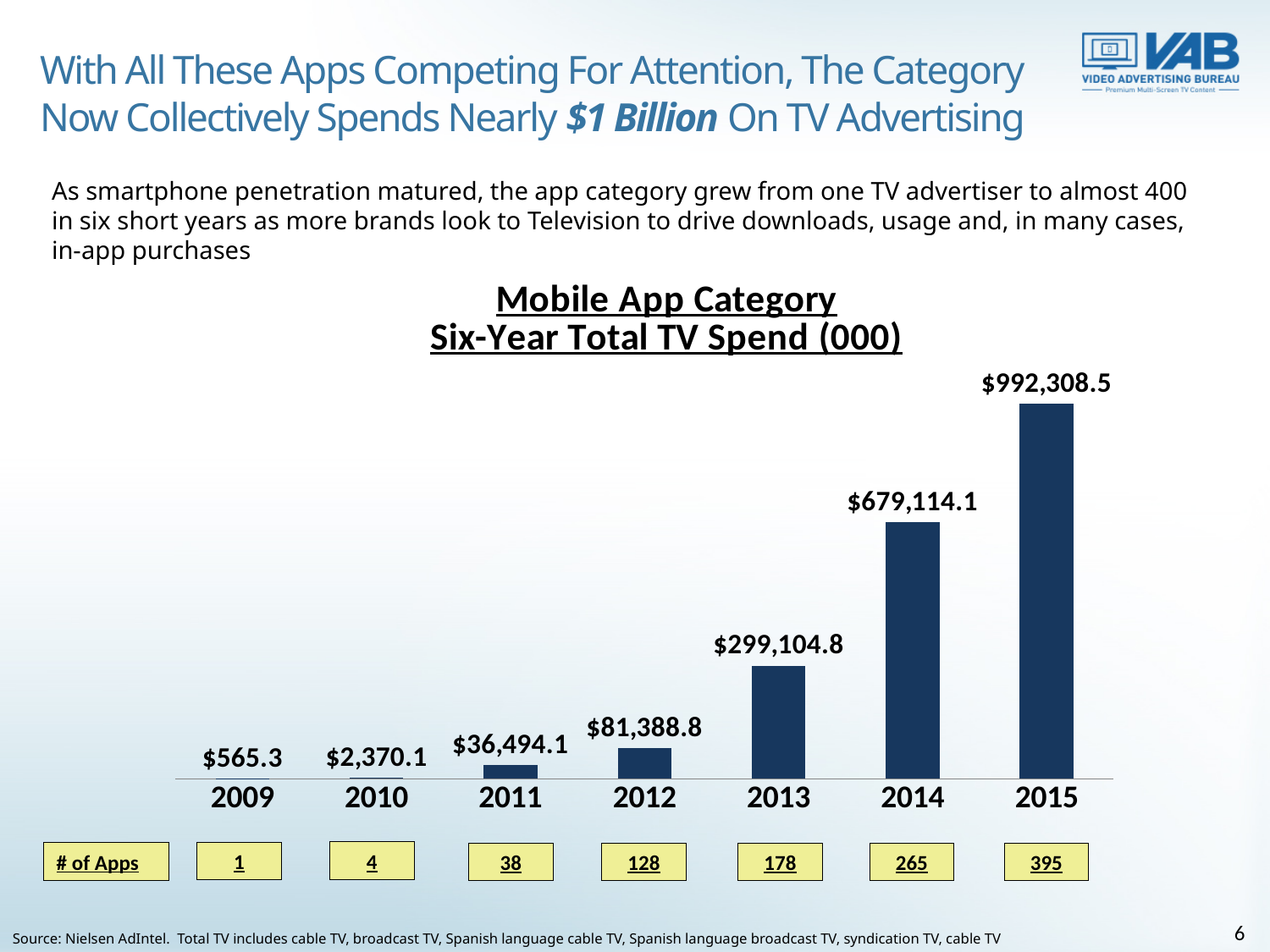
What is the value for 2011 in the Mobile App Category Six-Year Total TV Spend chart? $36,494.1 Which year has the lowest total TV spend in the chart? 2009 What is the value for 2013 in the Mobile App Category Six-Year Total TV Spend chart? $299,104.8 What is the difference between the 2015 and 2014 values in the chart? $313,194.4 What kind of chart is shown on the slide? Bar chart What is the difference between the 2012 and 2011 values in the chart? $44,894.7 What is the value for 2015 in the Mobile App Category Six-Year Total TV Spend chart? $992,308.5 What is the value for 2009 in the Mobile App Category Six-Year Total TV Spend chart? $565.3 Do the values in the chart rise or fall from 2009 to 2015? Rise Which year has the highest total TV spend in the chart? 2015 Which is larger in the chart, the value for 2013 or the value for 2014? 2014 How many years are shown as bars in the chart? 7